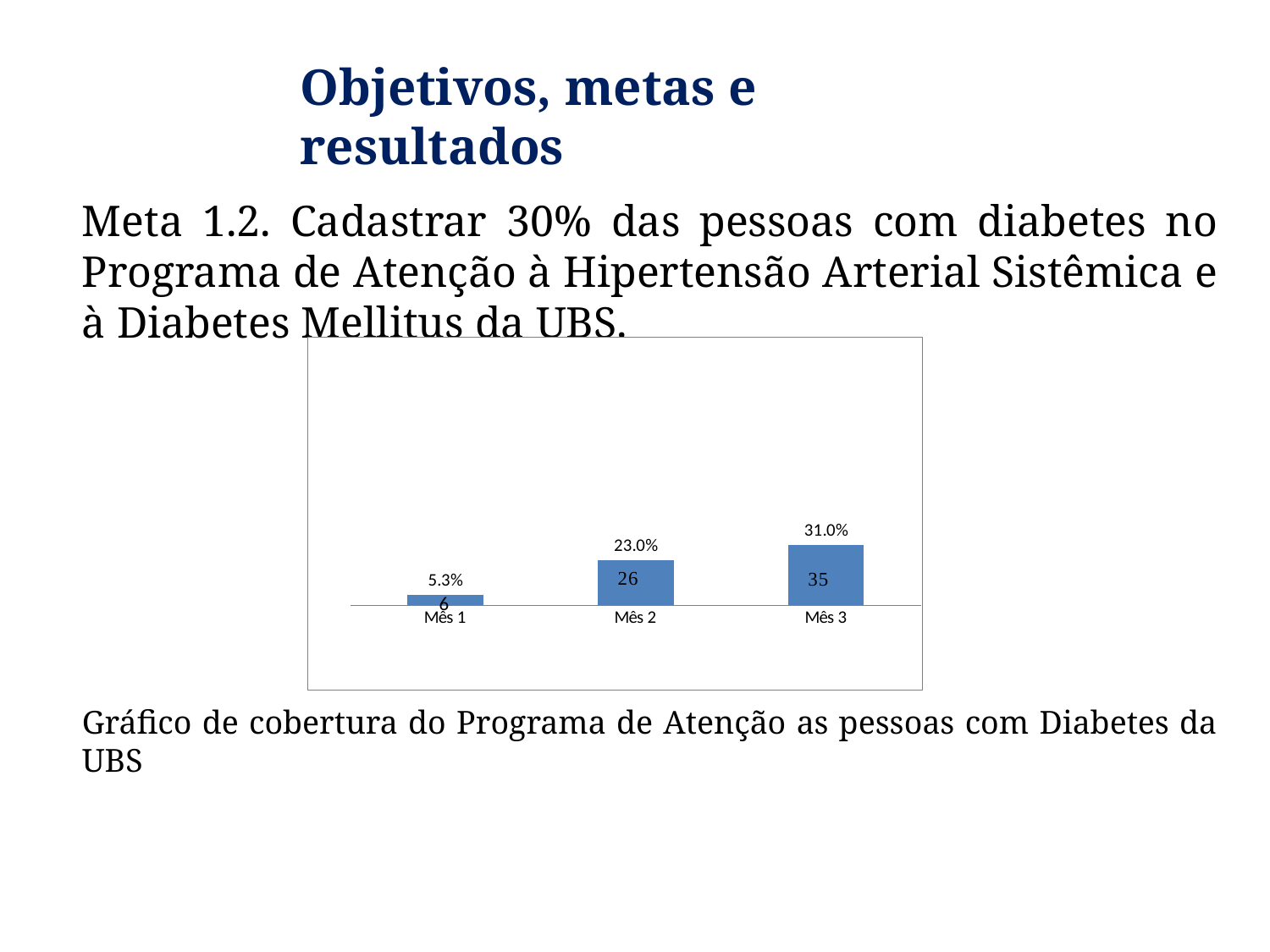
Do the values rise or fall from Mês 1 to Mês 3? rise What number is printed inside the bar for Mês 3? 35 What percentage is shown for Mês 3? 31.0% What percentage is shown for Mês 2? 23.0% What is the difference between the number of people in Mês 3 and Mês 2? 9 What is the difference in percentage points between Mês 3 and Mês 1? 25.7 Which is larger, the value for Mês 2 or the value for Mês 1? Mês 2 How many months are shown on the chart? 3 What number is printed on the bar for Mês 1? 6 Which month has the lowest coverage percentage? Mês 1 What percentage is shown for Mês 1? 5.3% Which month has the highest coverage percentage? Mês 3